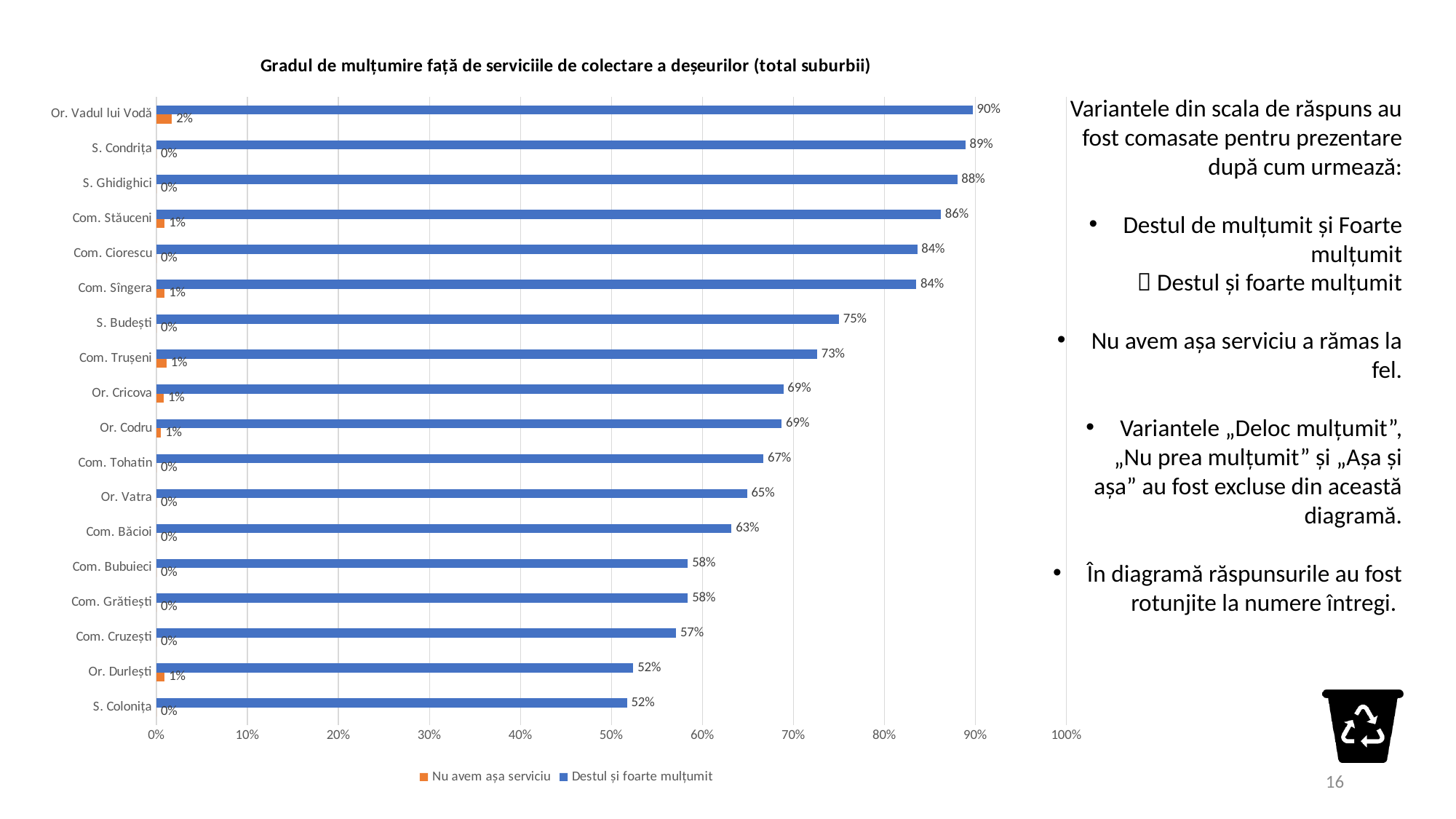
What is the difference between the "Destul și foarte mulțumit" values for S. Budești and Com. Trușeni? 2 percentage points Which locality has the highest value for "Destul și foarte mulțumit"? Or. Vadul lui Vodă What is the value of "Destul și foarte mulțumit" for Com. Trușeni? 73% How many series does the legend list? 2 What type of chart is shown on the slide? Bar chart What is the value of "Nu avem așa serviciu" for Or. Vadul lui Vodă? 2% What is the difference between the "Destul și foarte mulțumit" values for Or. Vadul lui Vodă and S. Colonița? 38 percentage points Which has a higher "Destul și foarte mulțumit" value, Com. Stăuceni or Or. Vatra? Com. Stăuceni What is the value of "Destul și foarte mulțumit" for S. Colonița? 52% How many localities are shown on the chart? 18 What is the value of "Destul și foarte mulțumit" for Or. Vadul lui Vodă? 90% What is the title of the chart? Gradul de mulțumire față de serviciile de colectare a deșeurilor (total suburbii)